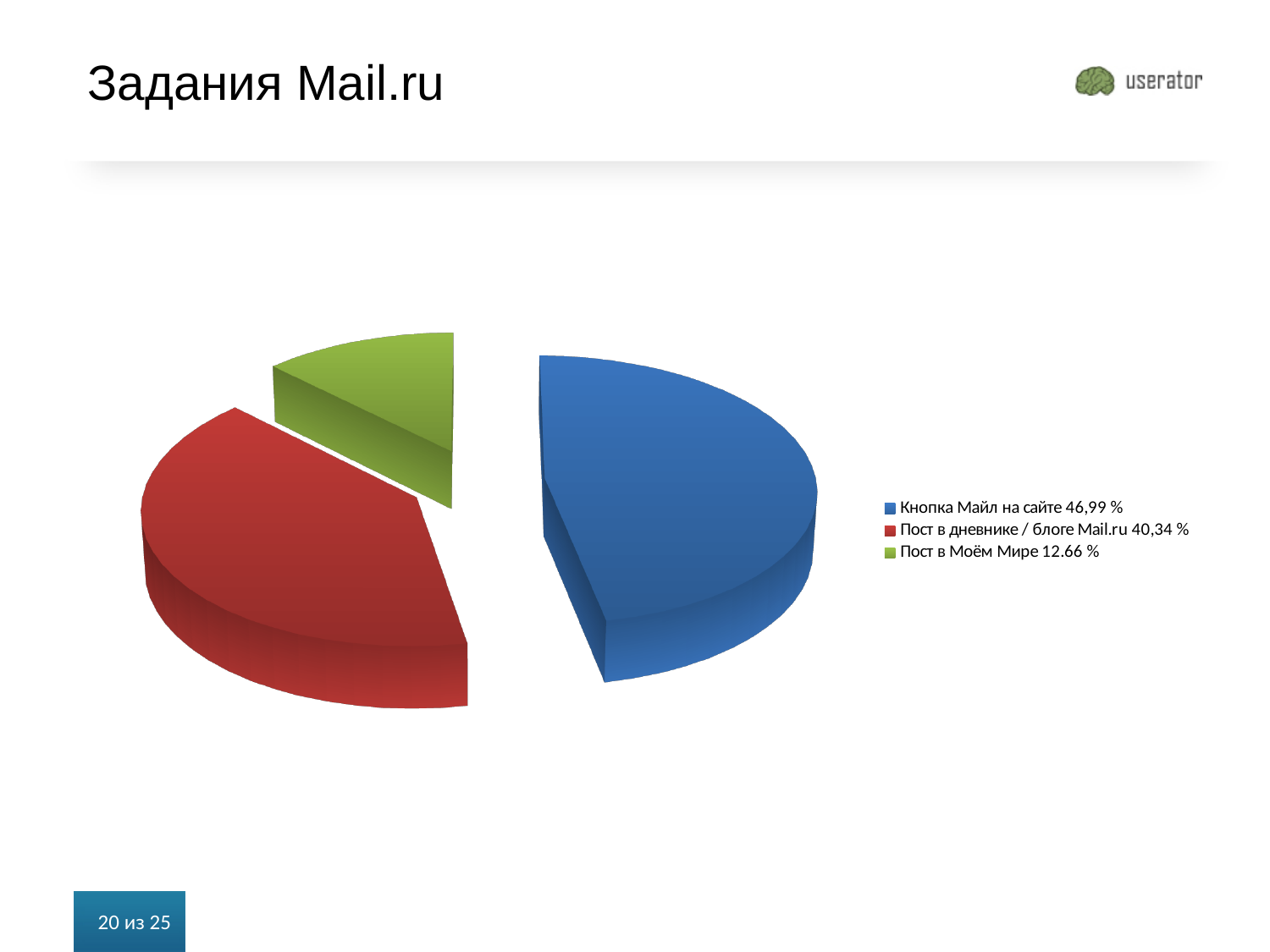
What share does "Пост в дневнике / блоге Mail.ru" have in the pie chart? 40,34 % What share does "Пост в Моём Мире" have in the pie chart? 12.66 % By how many percentage points does "Кнопка Майл на сайте" exceed "Пост в дневнике / блоге Mail.ru"? 6,65 % What share does "Кнопка Майл на сайте" have in the pie chart? 46,99 % What colour is the slice for "Пост в Моём Мире"? Green Which category has the largest share in the pie chart? Кнопка Майл на сайте Is the share for "Пост в Моём Мире" greater or less than 20%? less How many slices does the pie chart have? 3 What kind of chart is shown on the slide? Pie chart What is the title of the slide containing the pie chart? Задания Mail.ru Which is larger: the share for "Пост в дневнике / блоге Mail.ru" or for "Пост в Моём Мире"? Пост в дневнике / блоге Mail.ru Which category has the smallest share in the pie chart? Пост в Моём Мире